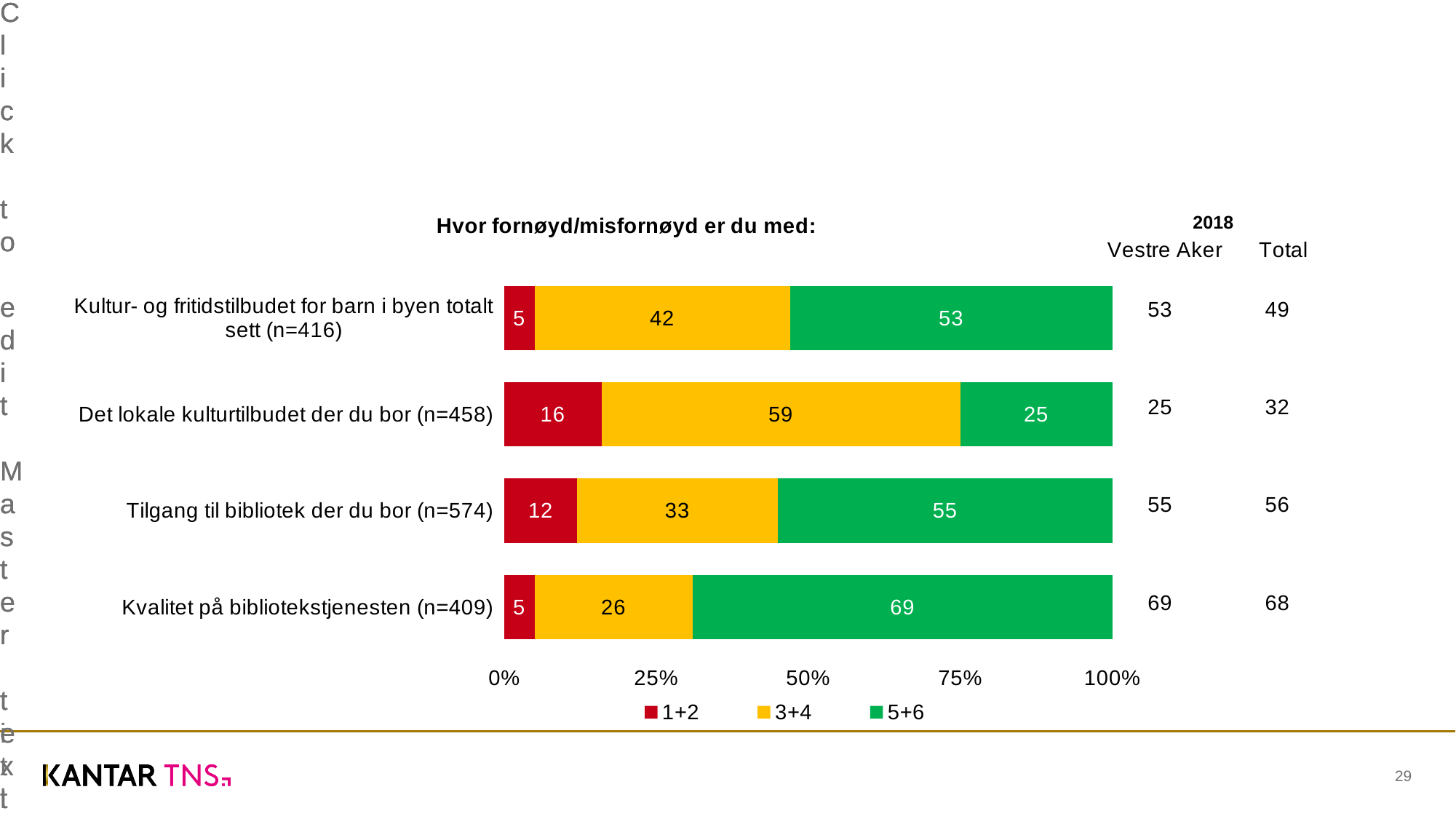
Which is larger: the 1+2 value for "Tilgang til bibliotek der du bor (n=574)" or for "Kultur- og fritidstilbudet for barn i byen totalt sett (n=416)"? Tilgang til bibliotek der du bor (n=574) What is the value of the 5+6 series for "Kvalitet på bibliotekstjenesten (n=409)"? 69 What is the value of the 3+4 series for "Tilgang til bibliotek der du bor (n=574)"? 33 What is the difference between the 3+4 values for "Det lokale kulturtilbudet der du bor (n=458)" and "Kvalitet på bibliotekstjenesten (n=409)"? 33 What is the value of the 1+2 series for "Det lokale kulturtilbudet der du bor (n=458)"? 16 Which category has the highest 5+6 value? Kvalitet på bibliotekstjenesten (n=409) How many series does the legend list? 3 Which category has the lowest 5+6 value? Det lokale kulturtilbudet der du bor (n=458) What is the title of the chart? Hvor fornøyd/misfornøyd er du med: How many categories are shown in the chart? 4 What kind of chart is shown on the slide? Stacked bar chart What is the total of the stacked bar for "Kultur- og fritidstilbudet for barn i byen totalt sett (n=416)"? 100